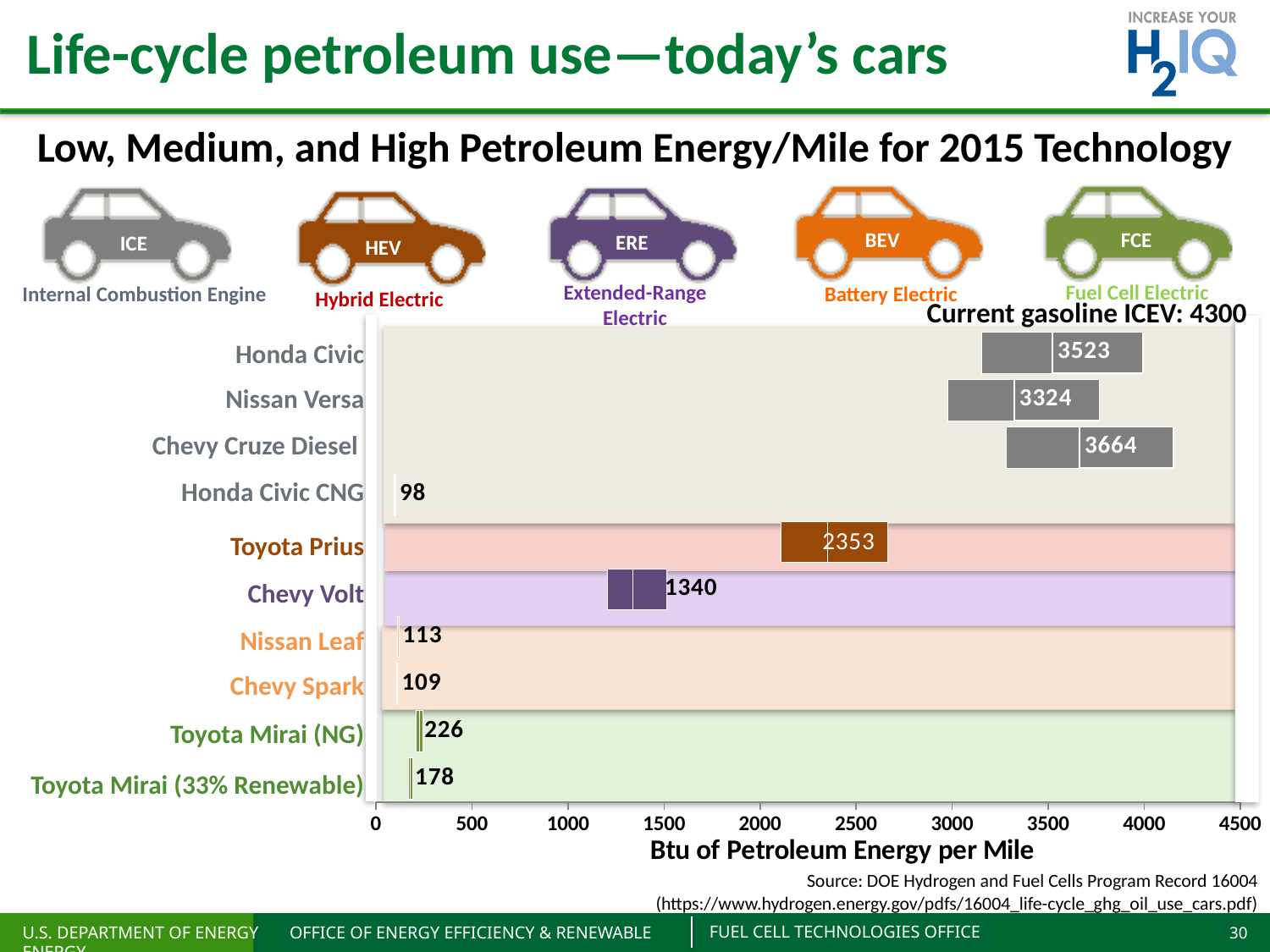
Which vehicle has the lowest labeled value? Honda Civic CNG What is the difference between the labeled values for the Toyota Mirai (NG) and the Toyota Mirai (33% Renewable)? 48 Which vehicle has the highest labeled value? Chevy Cruze Diesel What is the labeled value for the Toyota Prius? 2353 What is the labeled value for the Chevy Volt? 1340 What is the title of the x axis of the chart? Btu of Petroleum Energy per Mile What is the labeled value for the Toyota Mirai (NG)? 226 What is the difference between the labeled values for the Chevy Cruze Diesel and the Honda Civic? 141 What kind of chart is shown on the slide? Bar chart Which has the larger labeled value, the Toyota Prius or the Chevy Volt? Toyota Prius How many vehicles are listed on the chart? 10 What is the labeled value for the Nissan Versa? 3324